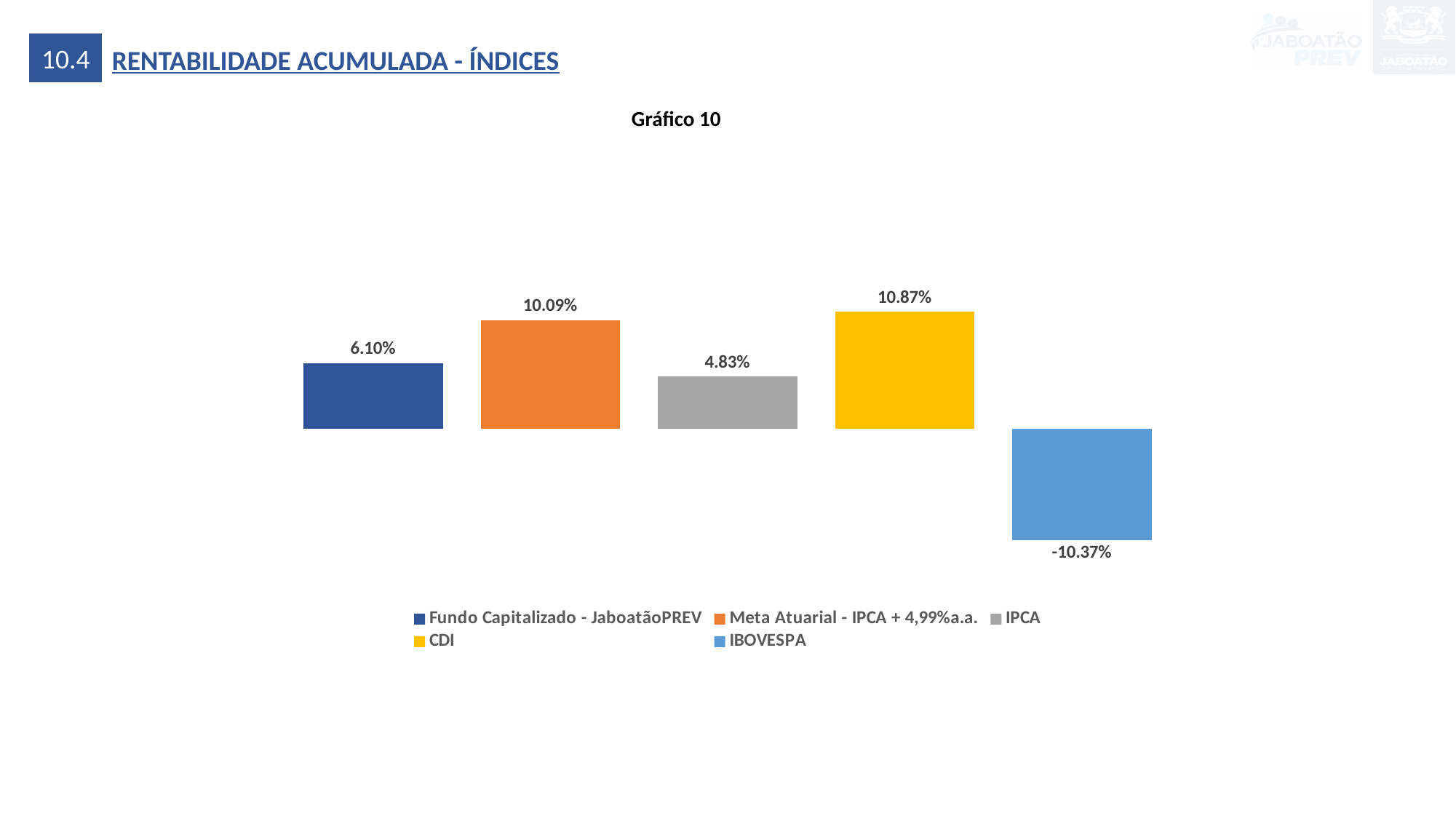
What is the value for Fundo Capitalizado - JaboatãoPREV? 6.10% What is the value for CDI? 10.87% What is the value for IBOVESPA? -10.37% How many series does the legend list? 5 What is the difference between the CDI value and the Fundo Capitalizado - JaboatãoPREV value? 4.77% What is the value for Meta Atuarial - IPCA + 4,99%a.a.? 10.09% What kind of chart is shown? Bar chart What is the title of the chart? Gráfico 10 Which series has the highest value? CDI What is the value for IPCA? 4.83% Which series has the lowest value? IBOVESPA Which is larger, the value for Meta Atuarial - IPCA + 4,99%a.a. or the value for IPCA? Meta Atuarial - IPCA + 4,99%a.a.